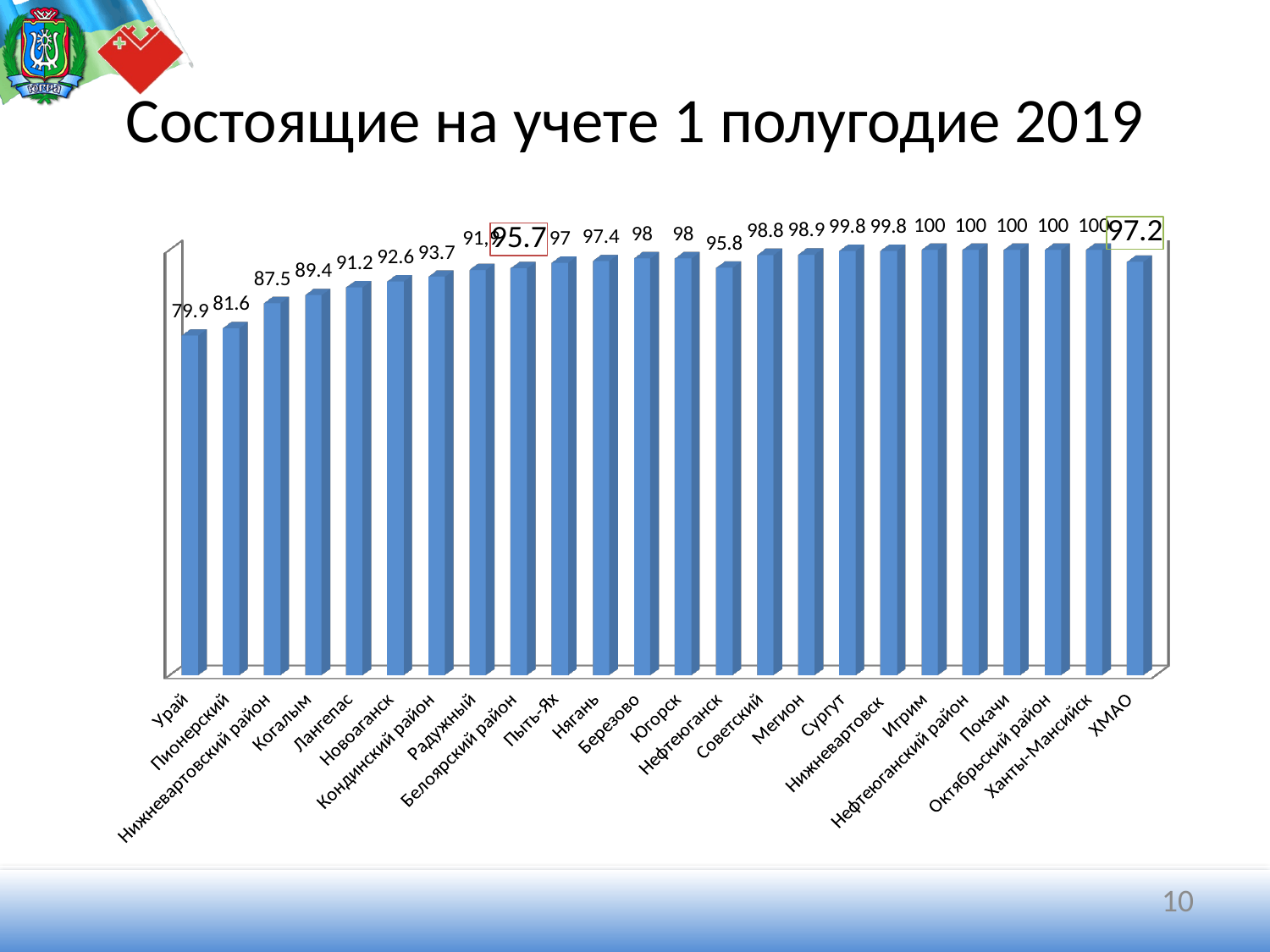
What is the difference between the values for Ханты-Мансийск and ХМАО? 2.8 What is the difference between the values for Пионерский and Урай? 1.7 Which has the larger value, Нягань or Пыть-Ях? Нягань What is the value for ХМАО? 97.2 What is the value for Когалым? 89.4 What is the title of the slide? Состоящие на учете 1 полугодие 2019 How many categories are shown on the x axis? 24 What is the value for Урай? 79.9 What is the value for Белоярский район? 95.7 What kind of chart is shown on the slide? Bar chart Which category has the lowest value? Урай What is the value for Нефтеюганск? 95.8